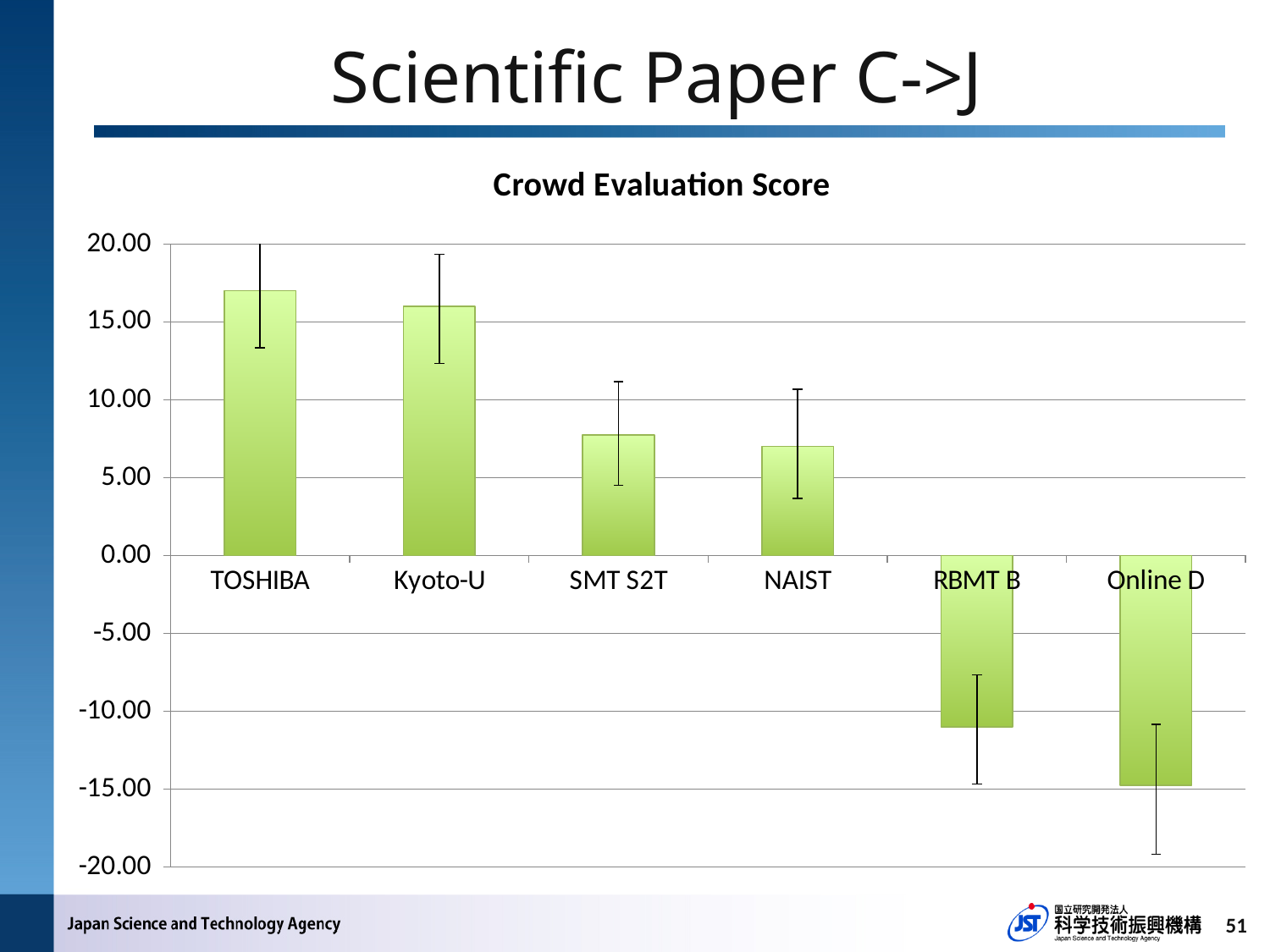
Which has the larger Crowd Evaluation Score, NAIST or RBMT B? NAIST Which has the larger Crowd Evaluation Score, TOSHIBA or SMT S2T? TOSHIBA Do the values generally rise or fall from left to right along the x axis? fall Is the value for TOSHIBA greater or less than 15.00? greater Is the value for NAIST greater or less than 5.00? greater Is the value for RBMT B greater or less than -5.00? less What is the title of the chart? Crowd Evaluation Score Which category has the lowest Crowd Evaluation Score? Online D How many categories are plotted on the x axis? 6 What kind of chart is shown on the slide? bar chart